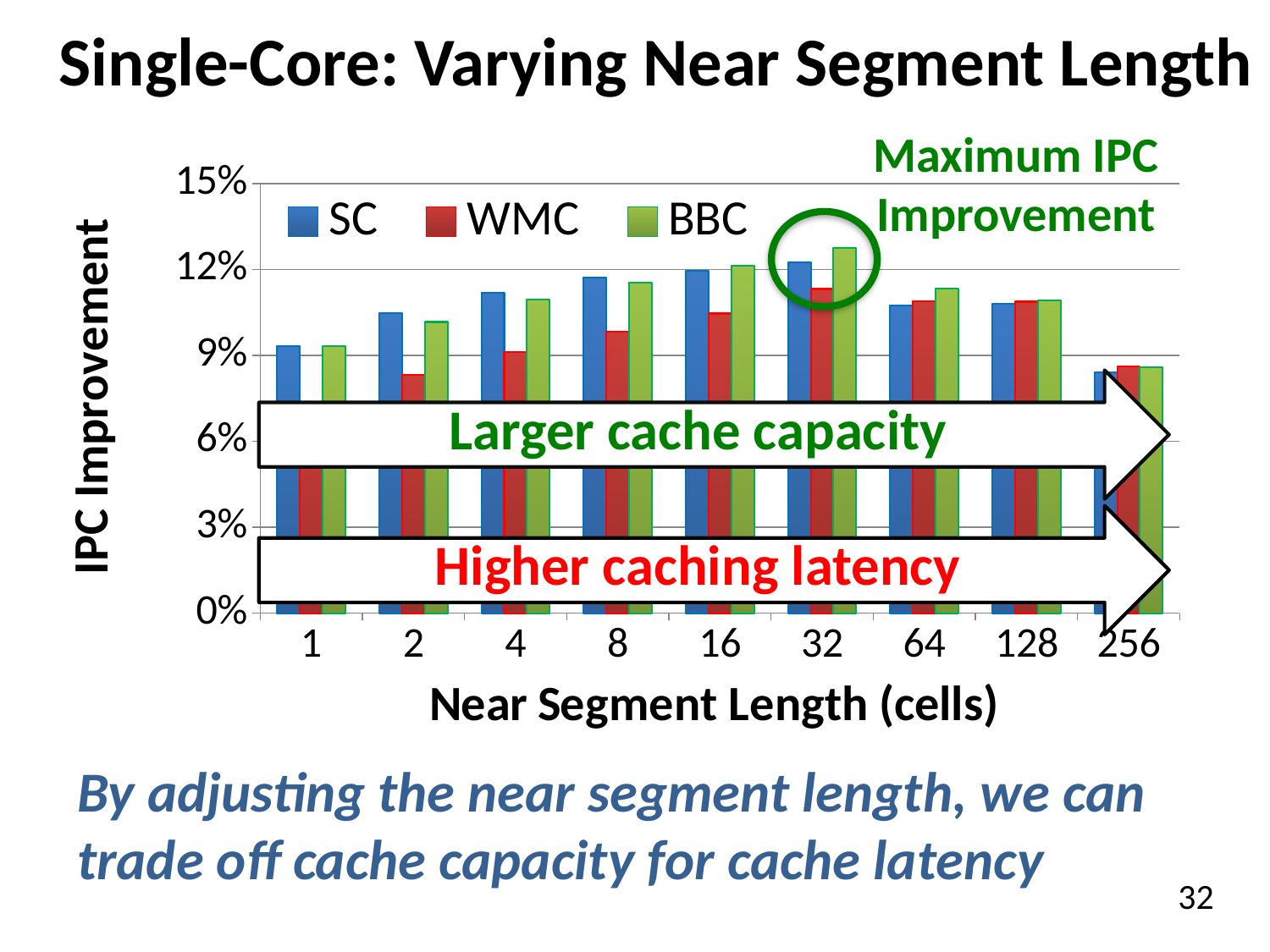
At which near segment length does BBC reach its maximum IPC improvement? 32 Which series has the highest IPC improvement at a near segment length of 32? BBC How many near segment length categories are shown on the x axis? 9 Which series has the lowest IPC improvement at a near segment length of 2? WMC What kind of chart is shown on the slide? bar chart How many series does the legend list? 3 Is the BBC value at a near segment length of 32 greater or less than 12%? greater At a near segment length of 8, which is larger, the SC value or the WMC value? SC Does the BBC IPC improvement rise or fall from a near segment length of 1 to 32? rise What is the label of the y axis? IPC Improvement Is the WMC value at a near segment length of 2 greater or less than 9%? less Is the SC value at a near segment length of 8 greater or less than 9%? greater